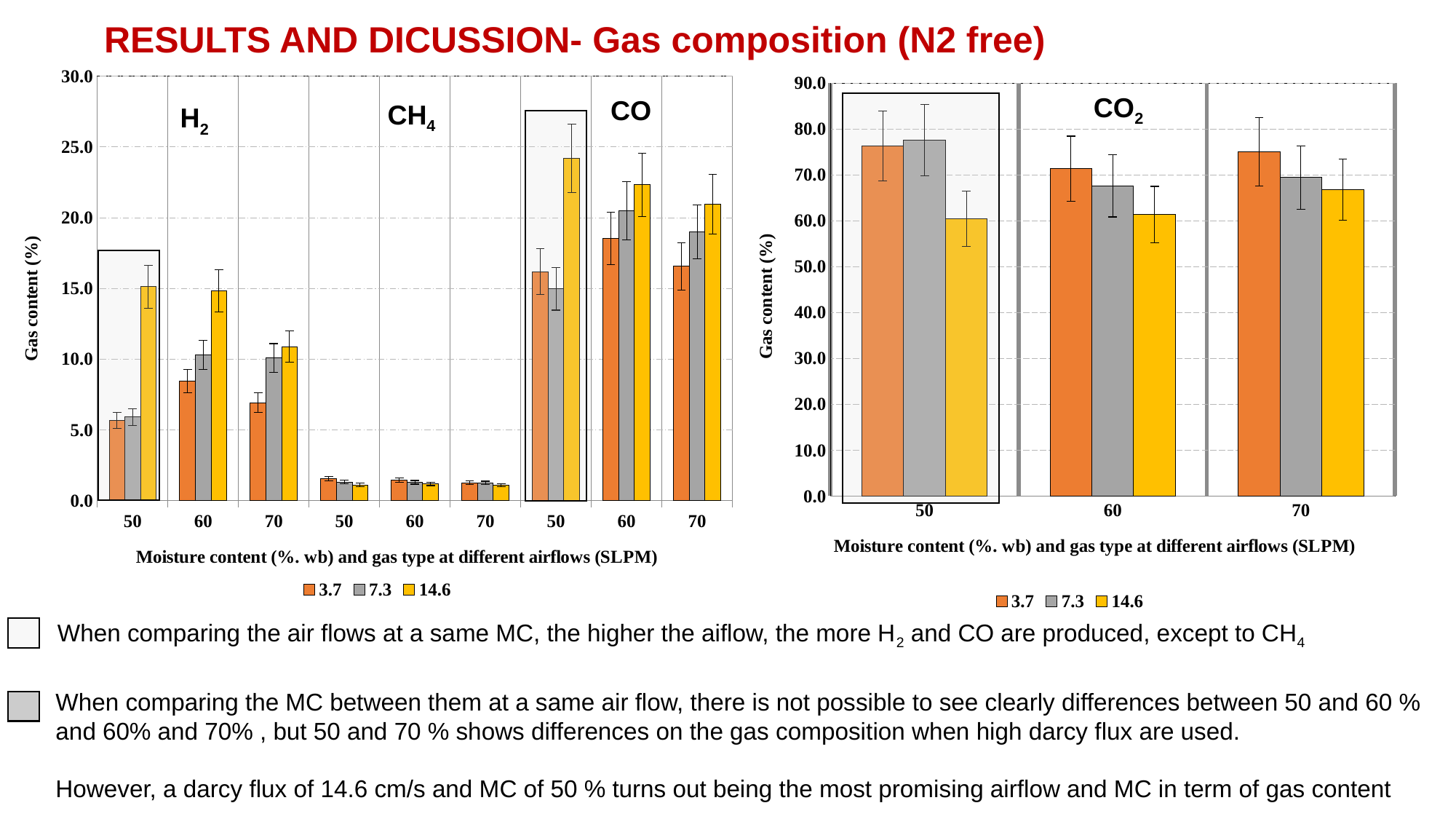
In the left chart, do the CO values for airflow 14.6 rise or fall as moisture content goes from 50 to 70? fall In the left chart, which airflow gives the highest H2 value at 50% moisture content? 14.6 What are the legend entries of the right (CO2) chart? 3.7, 7.3, 14.6 In the right (CO2) chart, at 70% moisture content, which is larger: the value for airflow 3.7 or for airflow 14.6? 3.7 In the left chart, is the CH4 value at 60% moisture content for airflow 3.7 greater or less than 5.0? less How many moisture content categories are shown on the x axis of the right (CO2) chart? 3 How many series does the legend of the left chart list? 3 In the right (CO2) chart, is the value at 50% moisture content for airflow 14.6 greater or less than 70.0? less In the left chart, is the CO value at 50% moisture content for airflow 14.6 greater or less than 20.0? greater In the right (CO2) chart, which airflow gives the lowest value at 50% moisture content? 14.6 What kind of chart is the left chart showing H2, CH4 and CO? bar chart